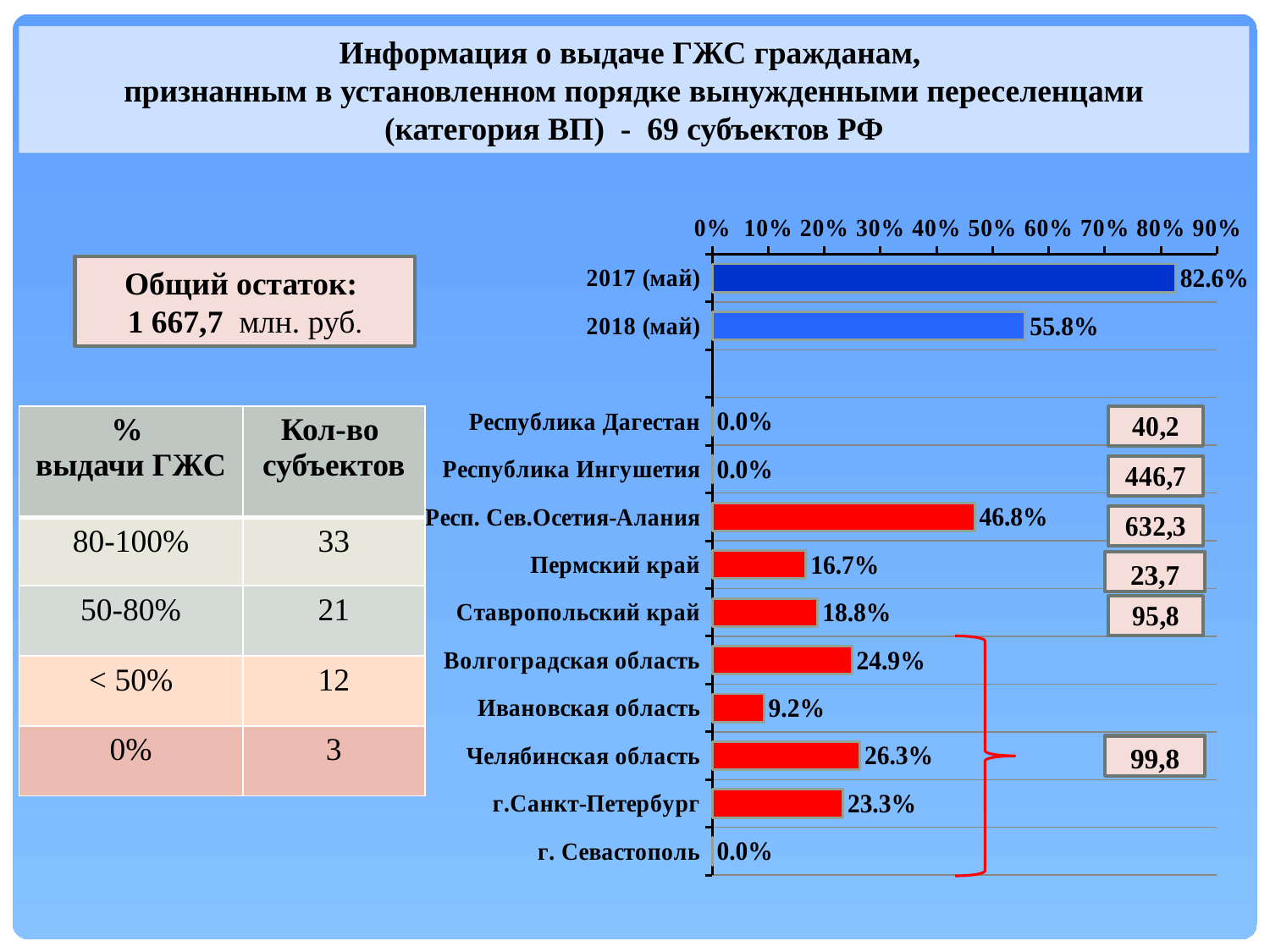
What is the difference between the values for Волгоградская область and Ивановская область? 15.7% What is the value for Ивановская область on the chart? 9.2% What is the value for Республика Дагестан on the chart? 0.0% How many categories are plotted on the chart? 12 What is the value for 2017 (май) on the chart? 82.6% What is the value for Респ. Сев.Осетия-Алания on the chart? 46.8% Which is larger, the value for Челябинская область or the value for г.Санкт-Петербург? Челябинская область Which category has the highest value on the chart? 2017 (май) What kind of chart is shown on the slide? bar chart What is the difference between the values for 2017 (май) and 2018 (май)? 26.8% Which is larger, the value for Пермский край or the value for Ставропольский край? Ставропольский край What is the value for 2018 (май) on the chart? 55.8%